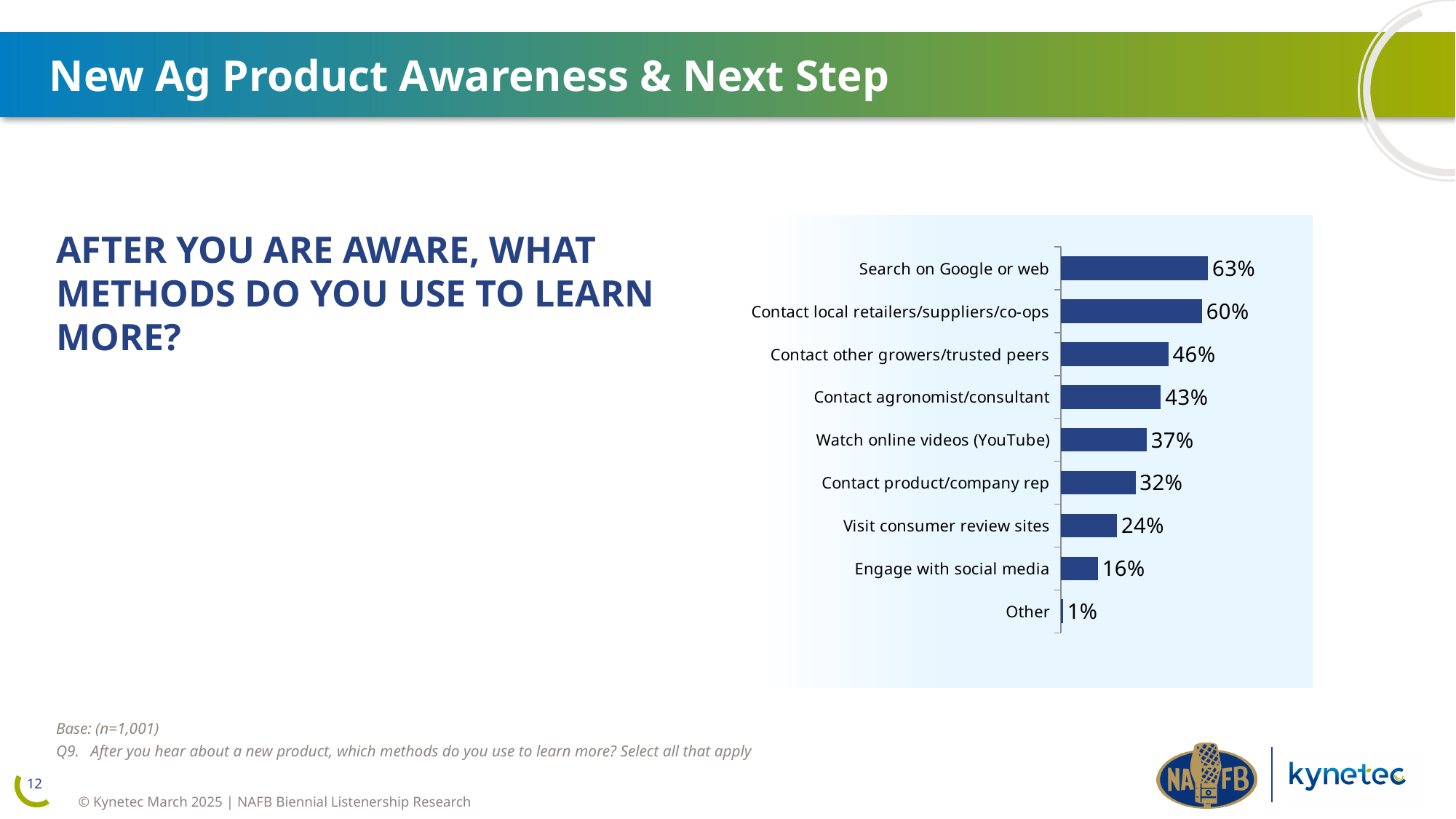
Which is larger: 'Contact other growers/trusted peers' or 'Contact product/company rep'? Contact other growers/trusted peers Which method has the lowest percentage? Other What percentage of respondents search on Google or web to learn more about a new product? 63% How many methods are shown in the chart? 9 What is the value for 'Contact agronomist/consultant'? 43% What is the difference between 'Search on Google or web' and 'Contact local retailers/suppliers/co-ops'? 3 percentage points What type of chart is shown on the slide? Bar chart What is the difference between 'Watch online videos (YouTube)' and 'Visit consumer review sites'? 13 percentage points What is the value for 'Visit consumer review sites'? 24% What percentage of respondents engage with social media to learn more? 16% What is the base sample size noted below the chart? n=1,001 Which method has the highest percentage? Search on Google or web